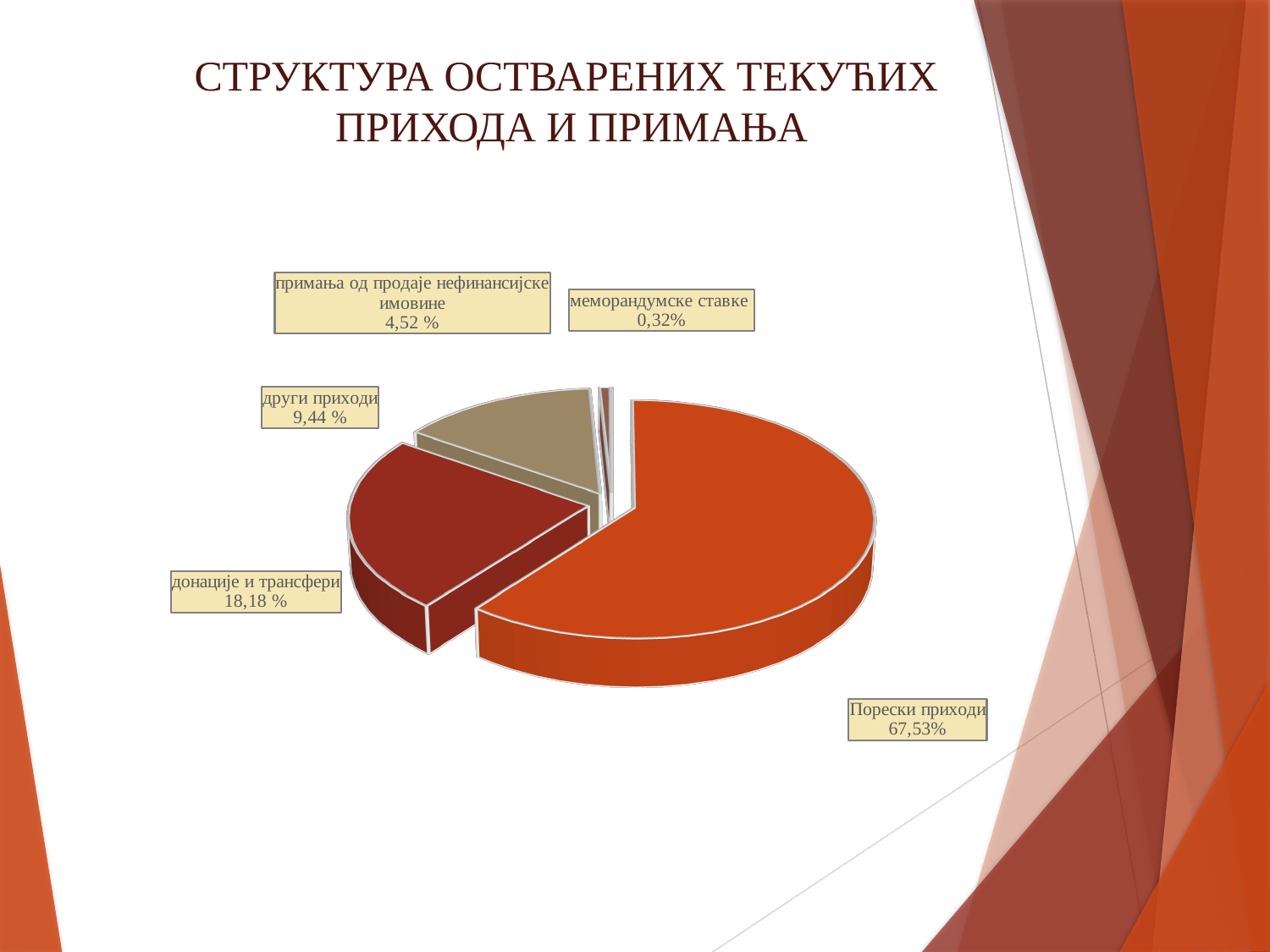
What is the value shown for примања од продаје нефинансијске имовине? 4,52 % What is the value shown for донације и трансфери? 18,18 % How many slices does the pie chart have? 5 What is the title of the slide? СТРУКТУРА ОСТВАРЕНИХ ТЕКУЋИХ ПРИХОДА И ПРИМАЊА What is the value shown for Порески приходи? 67,53% Which category has the largest share of the pie? Порески приходи Which is larger, донације и трансфери or други приходи? донације и трансфери Which category has the smallest share of the pie? меморандумске ставке What kind of chart is shown on the slide? pie chart What is the difference between the shares of Порески приходи and донације и трансфери? 49,35 % What is the value shown for други приходи? 9,44 % What is the value shown for меморандумске ставке? 0,32%